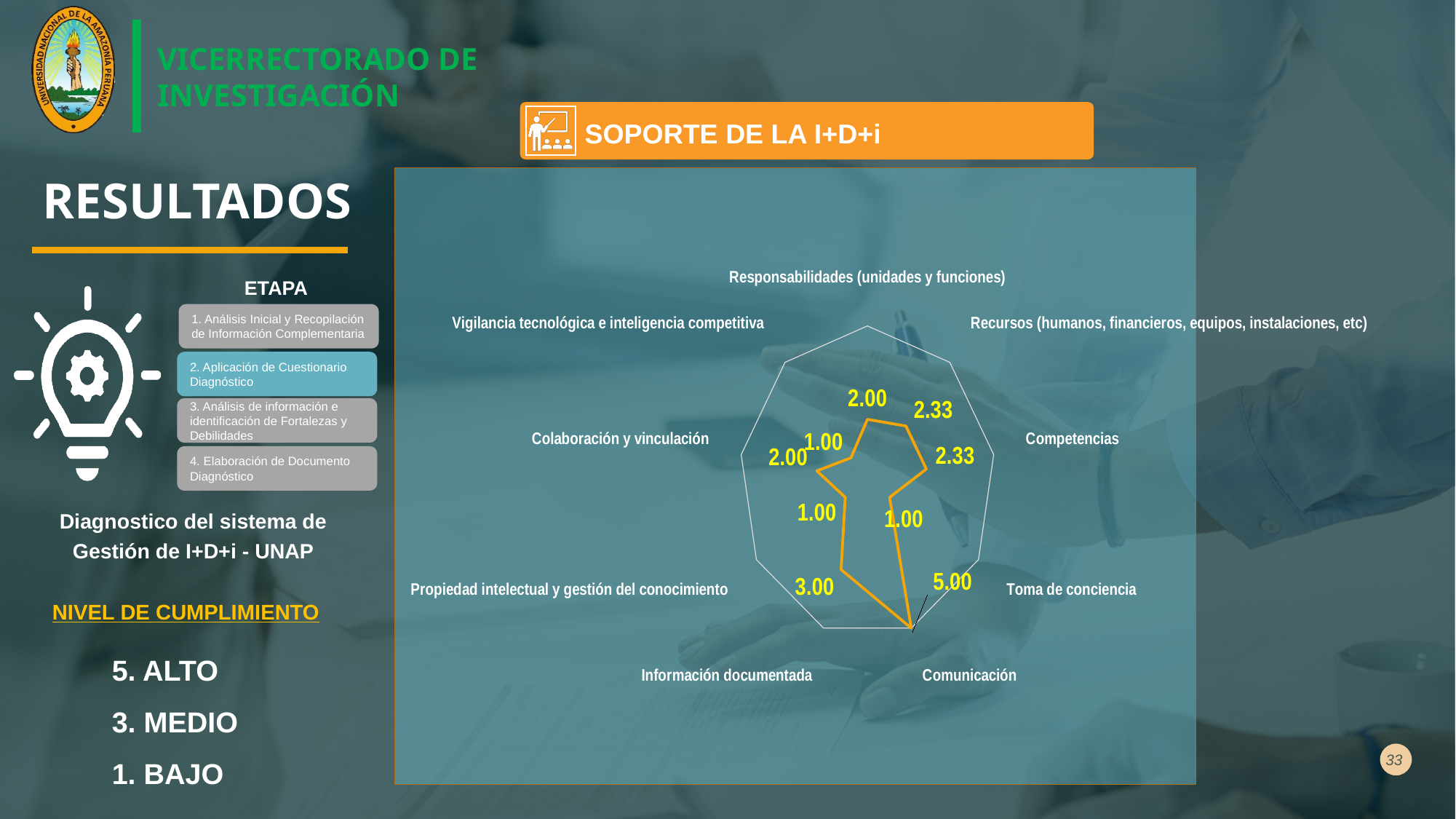
What is the value for Toma de conciencia? 1.00 What is the title shown above the chart? SOPORTE DE LA I+D+i How many categories does the radar chart have? 9 What is the value for Responsabilidades (unidades y funciones)? 2.00 What is the difference between the values for Información documentada and Propiedad intelectual y gestión del conocimiento? 2.00 What is the value for Comunicación? 5.00 What is the value for Información documentada? 3.00 What is the value for Competencias? 2.33 What is the difference between the values for Comunicación and Información documentada? 2.00 What kind of chart is shown on the slide? Radar chart Which is larger, the value for Recursos (humanos, financieros, equipos, instalaciones, etc) or the value for Colaboración y vinculación? Recursos (humanos, financieros, equipos, instalaciones, etc) Which category has the highest value? Comunicación